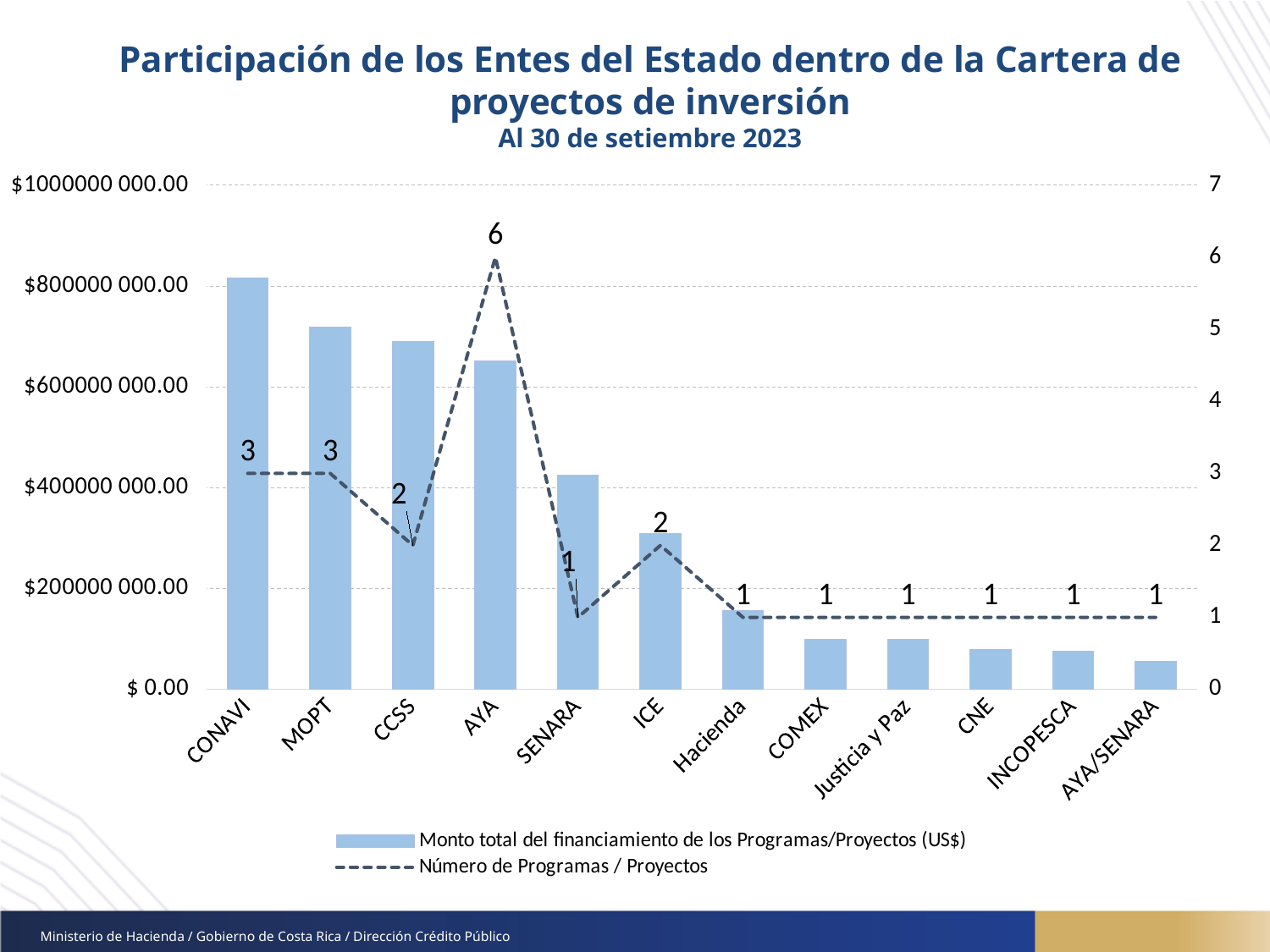
How many programs/projects does ICE have? 2 Is the total financing amount for CONAVI greater or less than $800000 000.00? greater Is the total financing amount for SENARA greater or less than $600000 000.00? less What is the difference between the number of programs/projects for AYA and for CONAVI? 3 Which entity has the highest number of programs/projects? AYA How many series does the legend list? 2 Which has a larger total financing amount, MOPT or ICE? MOPT How many programs/projects (Número de Programas / Proyectos) does AYA have? 6 Which entity has the lowest total financing amount? AYA/SENARA How many entities are shown on the x axis? 12 Which entity has the tallest bar for total financing amount (Monto total del financiamiento)? CONAVI How many programs/projects does CCSS have according to the dashed line? 2